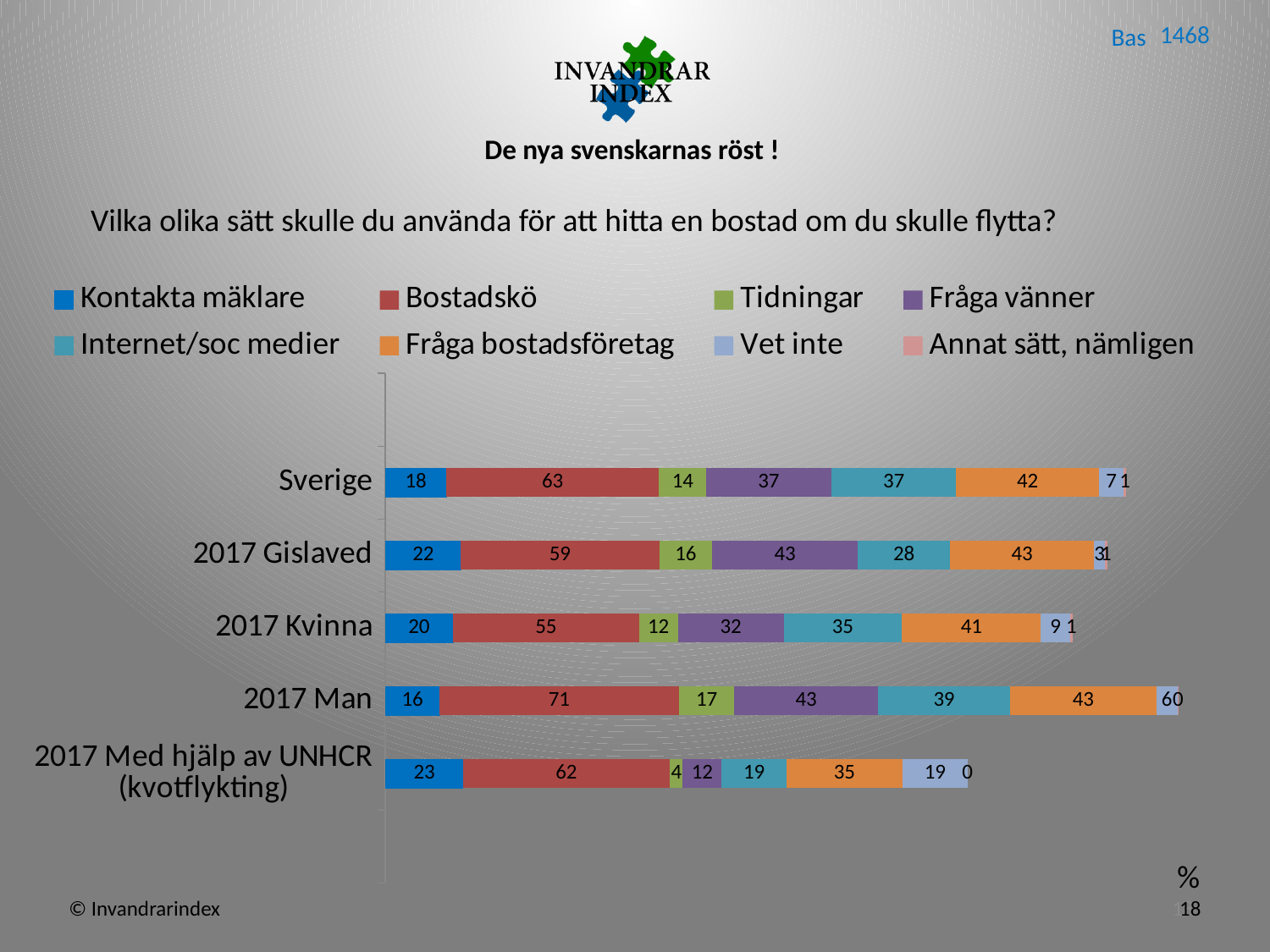
How many series does the legend list? 8 Which is larger: the Tidningar value for 2017 Gislaved or for 2017 Kvinna? 2017 Gislaved How many categories are plotted on the chart? 5 What is the difference between the Bostadskö values for 2017 Man and 2017 Kvinna? 16 What kind of chart is shown on the slide? stacked bar chart What is the value for Internet/soc medier in the 2017 Gislaved category? 28 Which category has the highest value for Bostadskö? 2017 Man Which category has the lowest value for Fråga vänner? 2017 Med hjälp av UNHCR (kvotflykting) What is the total of the stacked bar for 2017 Med hjälp av UNHCR (kvotflykting)? 174 What is the value for Fråga bostadsföretag in the Sverige category? 42 What is the value for Bostadskö in the 2017 Man category? 71 What is the value for Kontakta mäklare in the 2017 Med hjälp av UNHCR (kvotflykting) category? 23